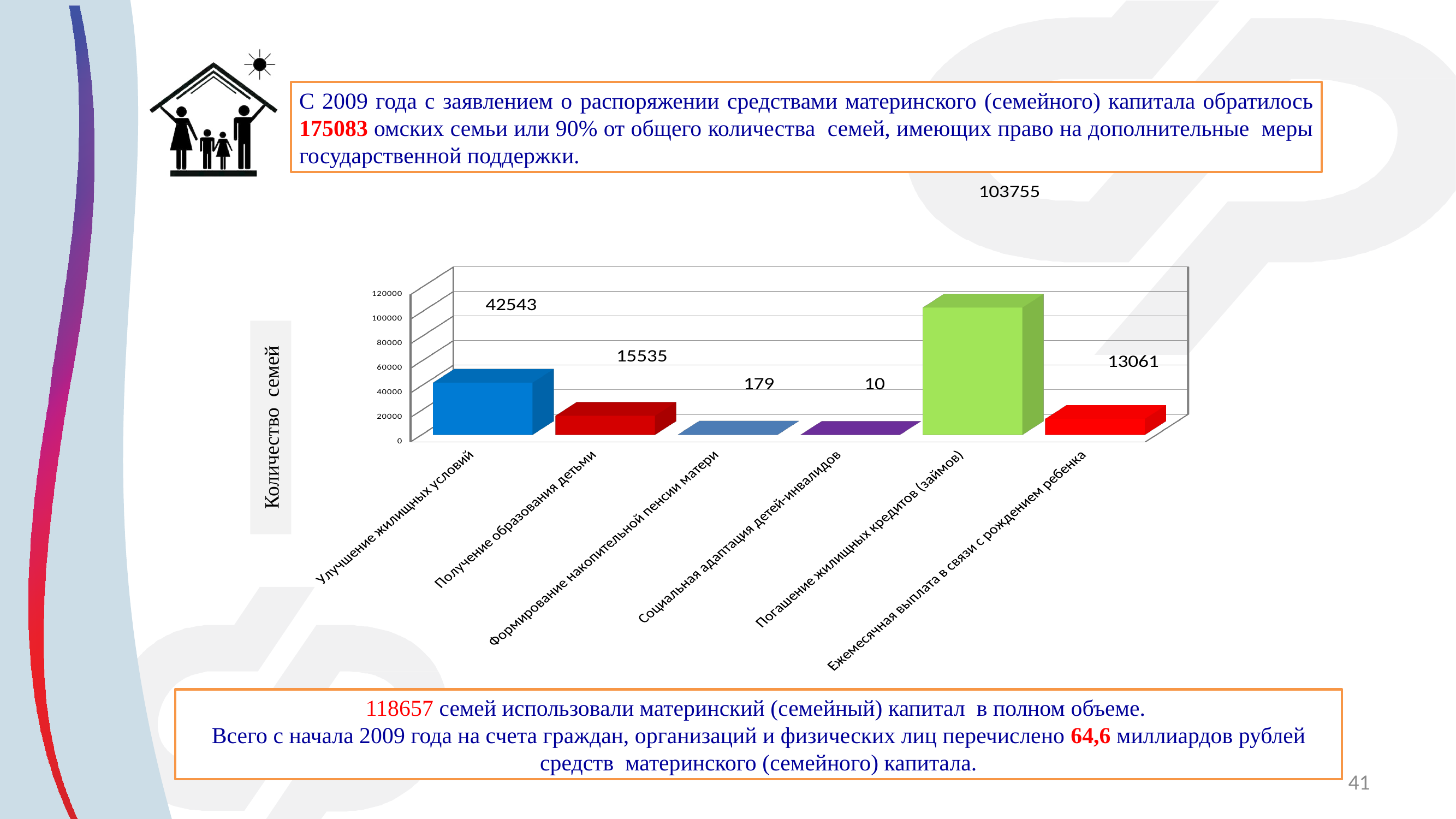
What is the label of the vertical axis of the chart? Количество семей What is the value for «Ежемесячная выплата в связи с рождением ребенка»? 13061 What is the value for «Получение образования детьми»? 15535 How many categories are shown in the chart? 6 What is the value for «Улучшение жилищных условий»? 42543 What kind of chart is shown on the slide? bar chart What is the difference between the values for «Погашение жилищных кредитов (займов)» and «Улучшение жилищных условий»? 61212 Which category has the lowest value? Социальная адаптация детей-инвалидов Is the value for «Погашение жилищных кредитов (займов)» greater or less than 100000? greater What is the value for «Социальная адаптация детей-инвалидов»? 10 Which is larger: the value for «Получение образования детьми» or for «Ежемесячная выплата в связи с рождением ребенка»? Получение образования детьми Which category has the highest value? Погашение жилищных кредитов (займов)